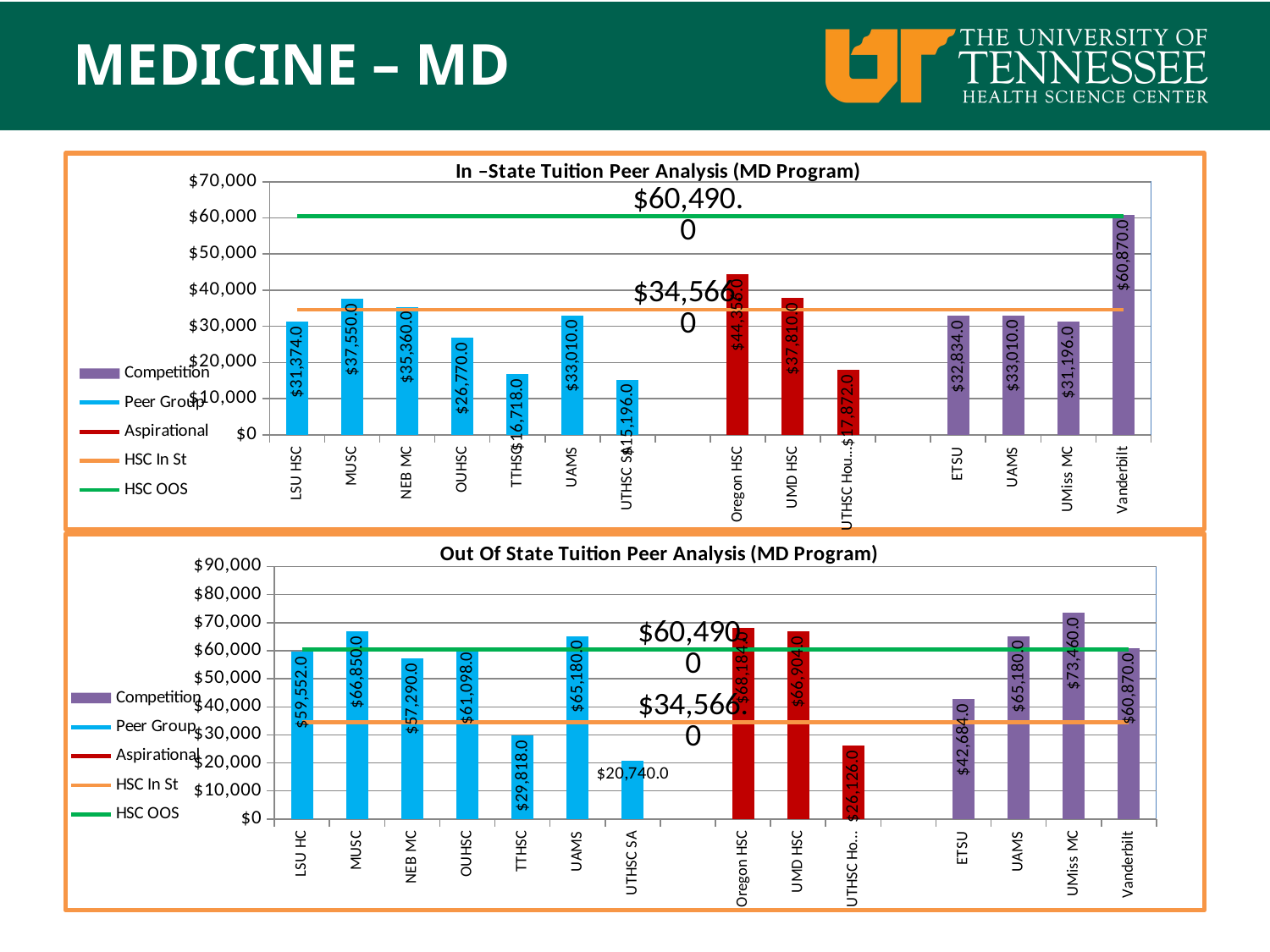
In the Out Of State Tuition Peer Analysis chart, which is larger, the tuition for OUHSC or for NEB MC? OUHSC In the Out Of State Tuition Peer Analysis chart, what is the tuition for TTHSC? $29,818.0 In the Out Of State Tuition Peer Analysis chart, what is the tuition for UMiss MC? $73,460.0 In the In-State Tuition Peer Analysis chart, which school has the lowest tuition? UTHSC SA What kind of chart is the Out Of State Tuition Peer Analysis chart? bar chart How many entries does the legend of the In-State Tuition Peer Analysis chart list? 5 In the In-State Tuition Peer Analysis chart, is the value for ETSU greater or less than $30,000? greater In the Out Of State Tuition Peer Analysis chart, which school has the highest tuition? UMiss MC In the In-State Tuition Peer Analysis chart, what is the in-state tuition for MUSC? $37,550.0 In the In-State Tuition Peer Analysis chart, which school has the highest tuition? Vanderbilt In the In-State Tuition Peer Analysis chart, how much higher is MUSC's tuition than LSU HSC's? $6,176.0 In the Out Of State Tuition Peer Analysis chart, which school has the lowest tuition? UTHSC SA